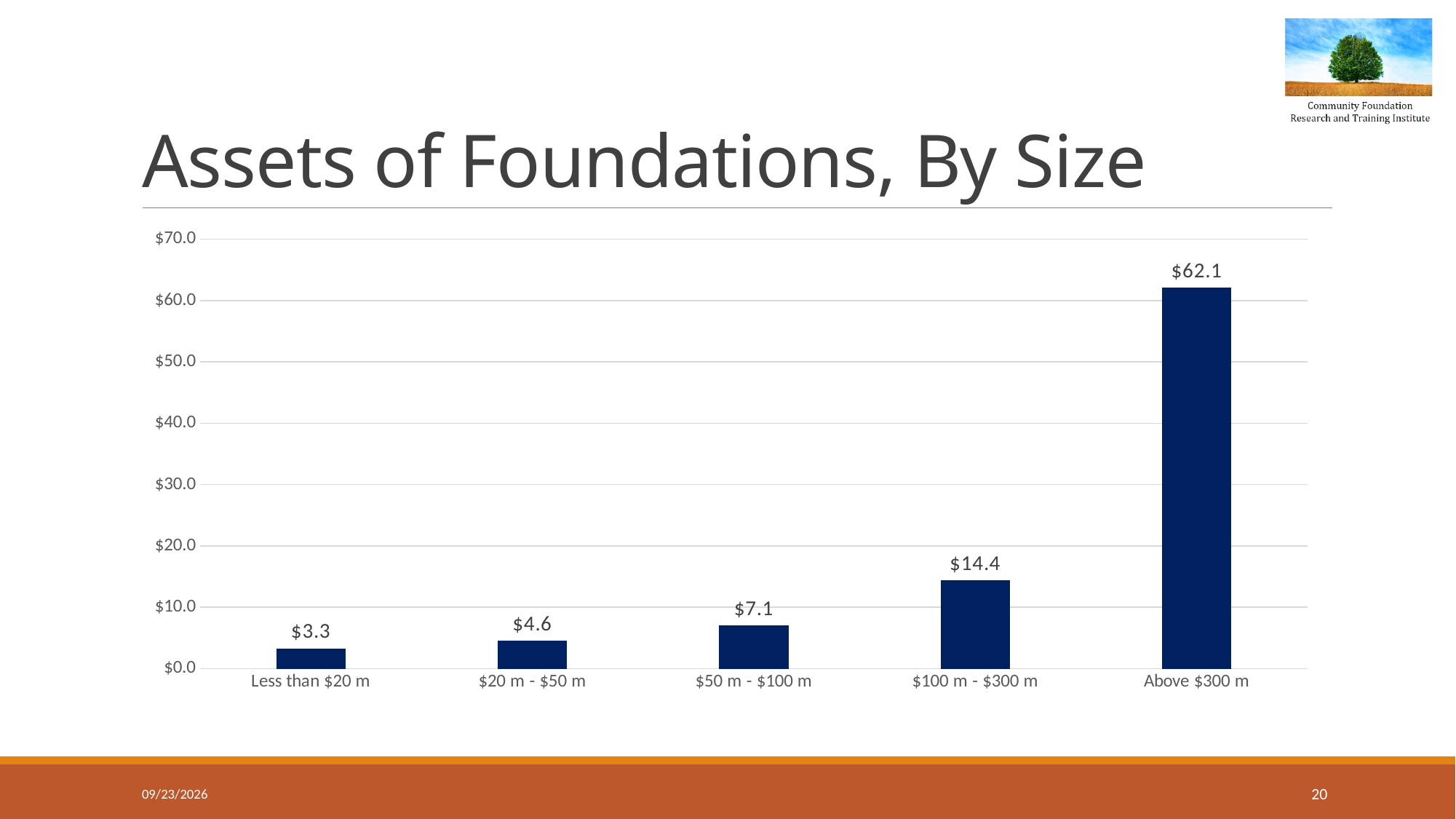
What is the value for the 'Above $300 m' category? $62.1 What is the value for the 'Less than $20 m' category? $3.3 What is the difference between the values for 'Above $300 m' and '$100 m - $300 m'? $47.7 What kind of chart is shown on the slide? Bar chart What is the difference between the values for '$20 m - $50 m' and 'Less than $20 m'? $1.3 Is the value for 'Above $300 m' greater or less than $60.0? greater Which category has the highest value? Above $300 m How many categories are shown on the x axis? 5 Which is larger, the value for '$100 m - $300 m' or the value for '$50 m - $100 m'? $100 m - $300 m Do the values rise or fall moving from left to right along the x axis? Rise What is the value for the '$50 m - $100 m' category? $7.1 Which category has the lowest value? Less than $20 m